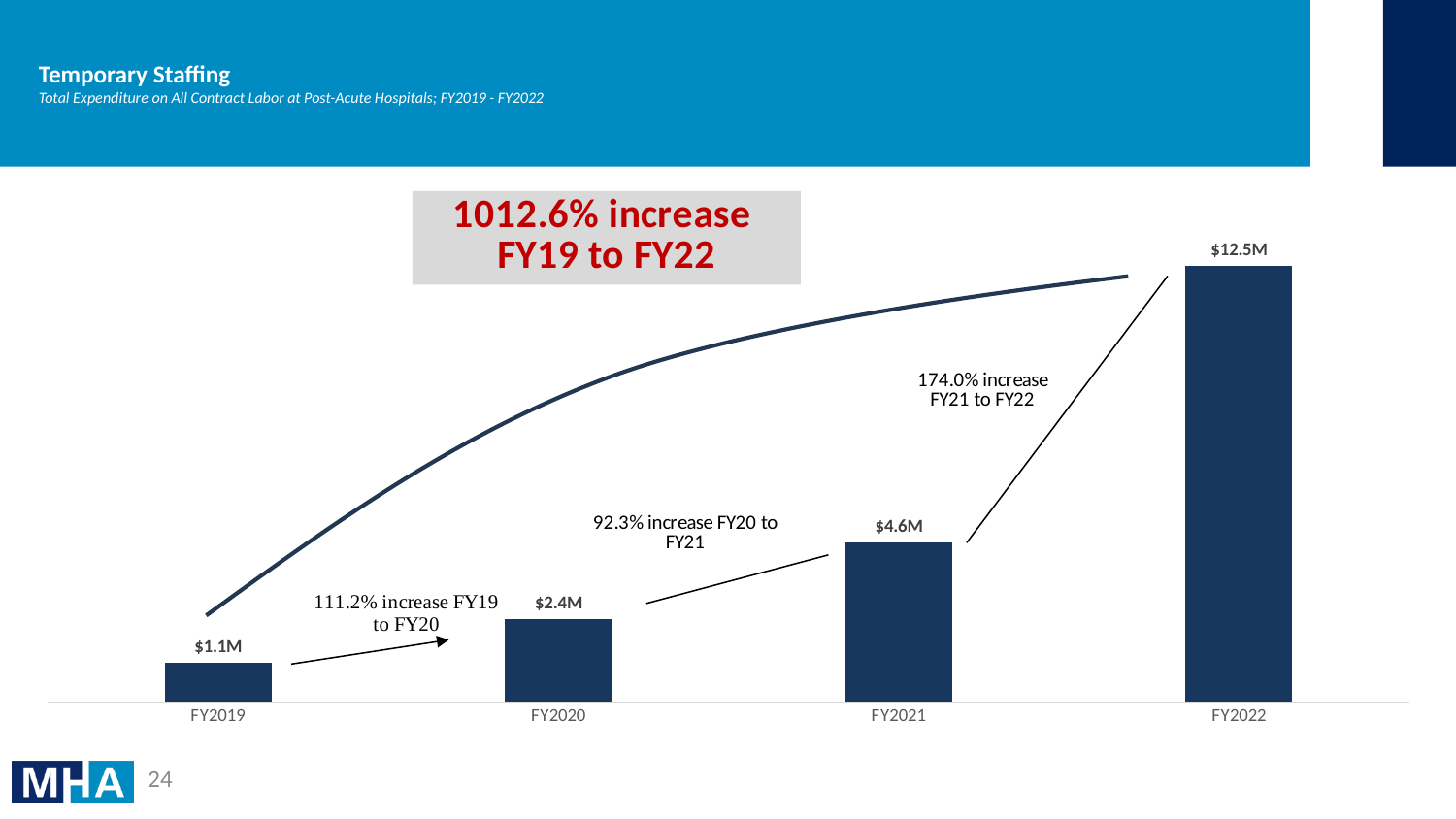
Which fiscal year has the lowest expenditure? FY2019 Do the values rise or fall from FY2019 to FY2022? Rise How many fiscal years are shown on the chart? 4 What is the difference between the FY2020 and FY2019 values? $1.3M Which fiscal year has the highest expenditure? FY2022 What is the difference between the FY2022 and FY2021 values? $7.9M Which is larger, the value for FY2021 or the value for FY2020? FY2021 What kind of chart is shown on the slide? Bar chart What is the value for FY2020? $2.4M What is the value for FY2021? $4.6M What is the value for FY2022? $12.5M What is the value for FY2019? $1.1M